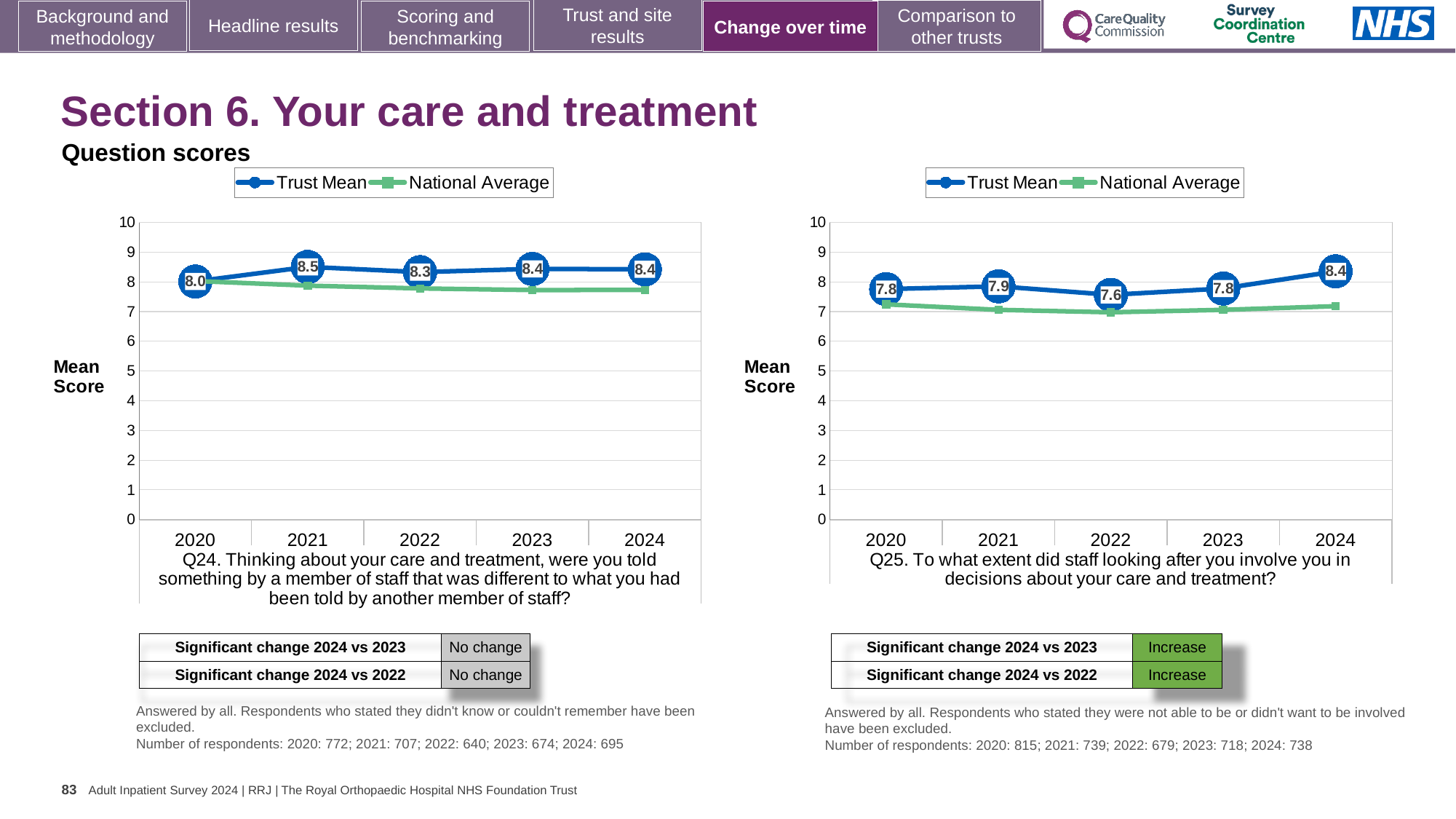
In the Q24 chart (left), which is larger, the Trust Mean score for 2021 or for 2022? 2021 What kind of chart is the Q24 chart (left)? Line chart In the Q25 chart (right), is the National Average value for 2024 greater or less than 8? less In the Q25 chart (right), does the Trust Mean score rise or fall from 2023 to 2024? Rise How many series does the legend of the Q25 chart (right) list? 2 In the Q24 chart (left), what is the Trust Mean score for 2020? 8.0 In the Q25 chart (right), which year has the lowest Trust Mean score? 2022 In the Q25 chart (right), what is the Trust Mean score for 2024? 8.4 How many years are plotted on the x axis of the Q24 chart (left)? 5 In the Q25 chart (right), what is the difference between the Trust Mean scores for 2024 and 2023? 0.6 In the Q24 chart (left), which year has the highest Trust Mean score? 2021 In the Q24 chart (left), what is the Trust Mean score for 2021? 8.5